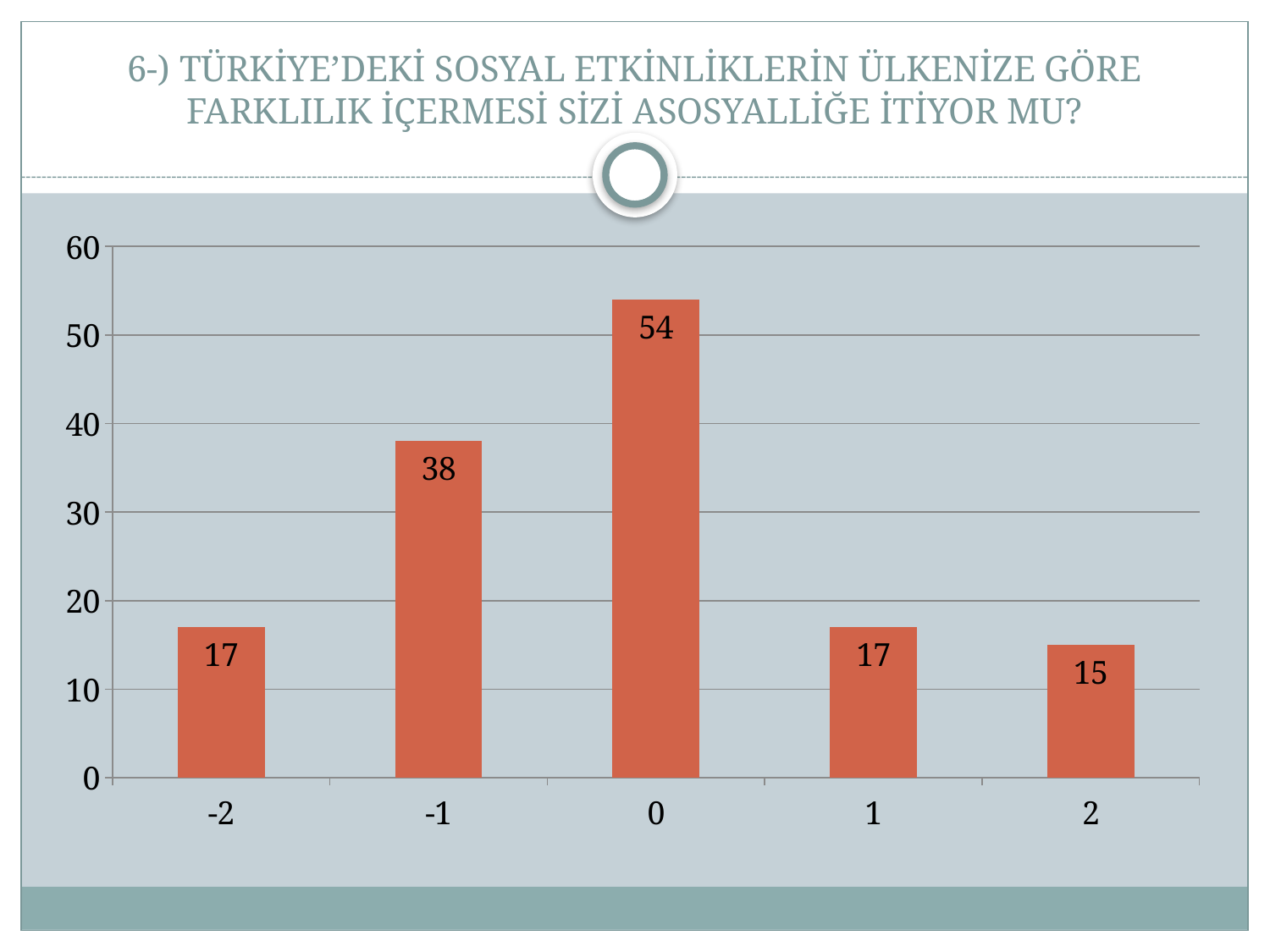
Which is larger, the value for category -1 or the value for category 1? -1 What is the highest value shown on the y axis? 60 What kind of chart is shown on the slide? bar chart What is the value for category 0? 54 What is the value for category -1? 38 Is the value for category 0 greater or less than 50? greater Which category has the highest value? 0 What is the value for category -2? 17 What is the difference between the values for category 0 and category -1? 16 Which category has the lowest value? 2 How many categories are shown on the x axis? 5 What is the value for category 2? 15